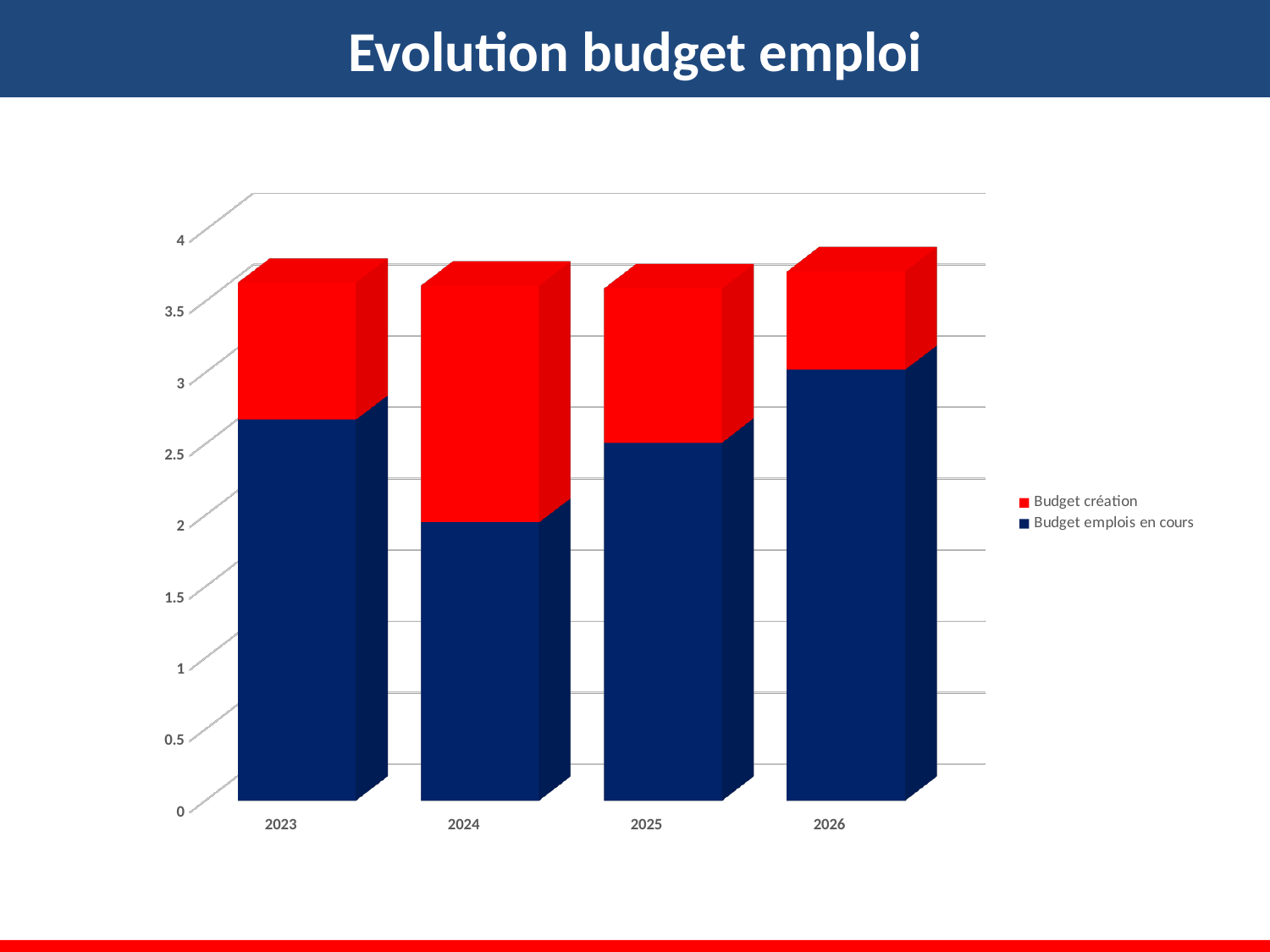
How many series does the legend list? 2 Does the value for 'Budget emplois en cours' rise or fall from 2024 to 2026? rise Is the value for 'Budget emplois en cours' in 2024 greater or less than 2.5? less Which is larger, 'Budget emplois en cours' in 2024 or in 2026? 2026 What is the title of the chart? Evolution budget emploi How many years are shown on the x axis? 4 Is the value for 'Budget emplois en cours' in 2026 greater or less than 2.5? greater What kind of chart is shown on the slide? Stacked bar chart Which year has the lowest value for 'Budget emplois en cours'? 2024 Which colour represents 'Budget création' in the chart? Red Which year has the largest 'Budget création' segment? 2024 Which year has the highest value for 'Budget emplois en cours'? 2026